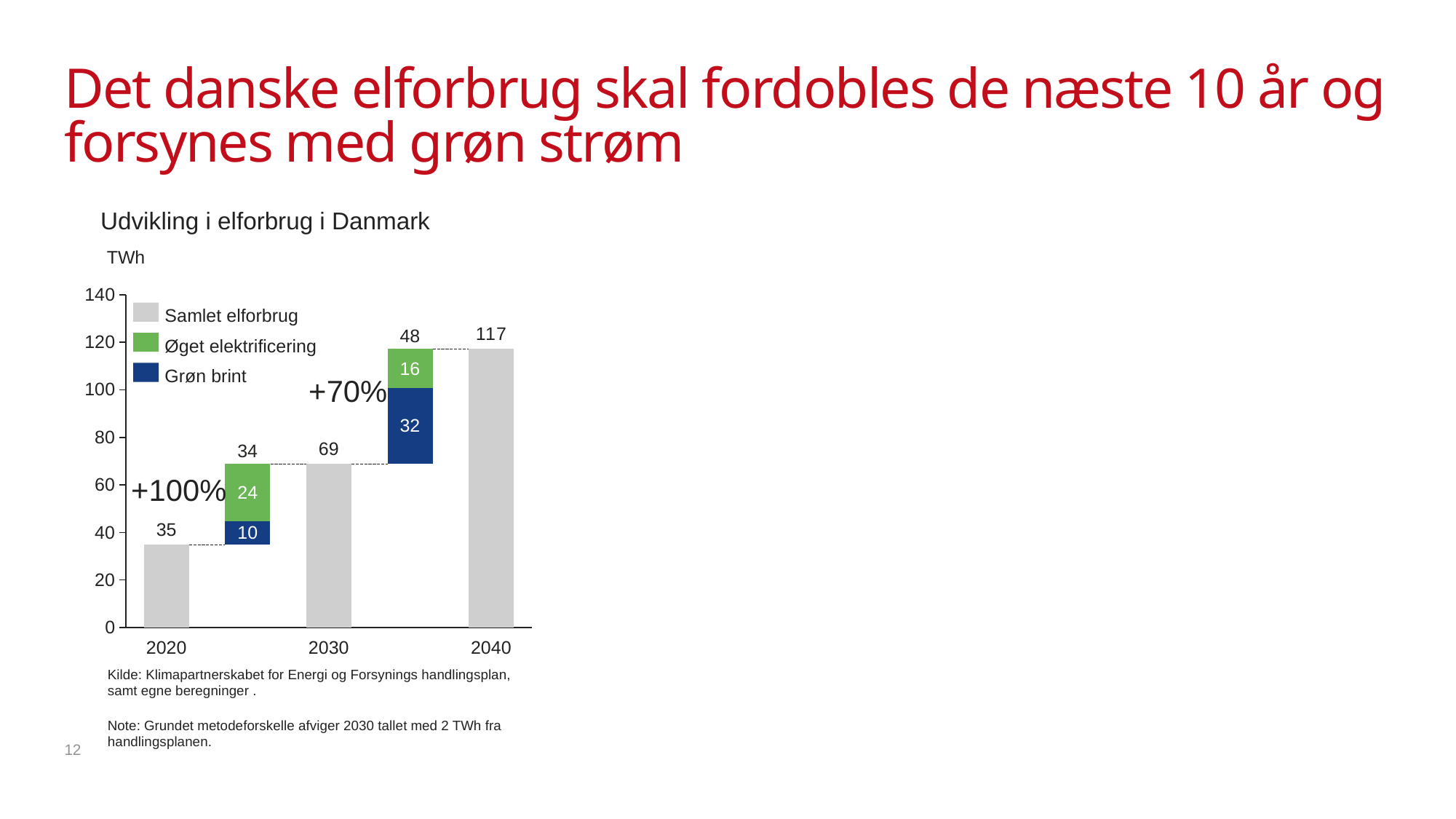
Which year has the highest Samlet elforbrug? 2040 What is the Øget elektrificering contribution between 2030 and 2040? 16 How many series does the legend list? 3 What kind of chart is shown? Bar chart What is the Grøn brint contribution between 2020 and 2030? 10 Which is larger in the 2020–2030 stacked bar: Øget elektrificering or Grøn brint? Øget elektrificering What is the value of Samlet elforbrug for 2040? 117 What is the difference between Samlet elforbrug in 2040 and in 2030? 48 What is the total of the stacked bar between 2030 and 2040? 48 What is the value of Samlet elforbrug for 2020? 35 What is the value of Samlet elforbrug for 2030? 69 What unit is shown on the chart's axis label? TWh